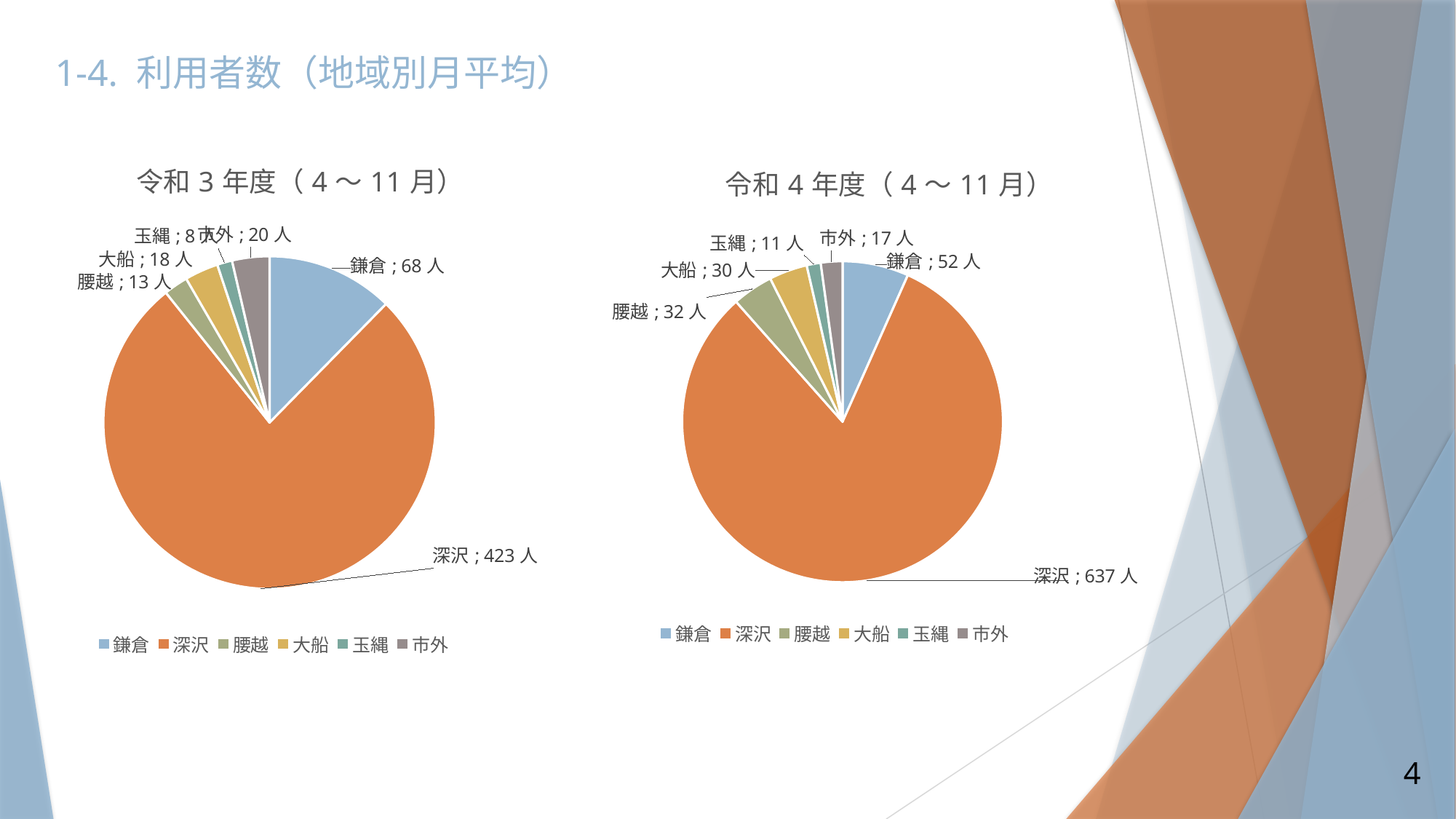
In the 令和4年度（4～11月） chart, what is the value for 鎌倉? 52 人 In the 令和3年度（4～11月） chart, which is larger, 大船 or 市外? 市外 In the 令和4年度（4～11月） chart, which category has the largest value? 深沢 In the 令和3年度（4～11月） chart, what is the difference between 鎌倉 and 大船? 50 人 What type of chart is used for 令和4年度（4～11月）? Pie chart In the 令和4年度（4～11月） chart, what is the value for 腰越? 32 人 In the 令和4年度（4～11月） chart, which is larger, 玉縄 or 市外? 市外 What colour represents 深沢 in the legend of the 令和4年度（4～11月） chart? Orange How many categories does the 令和3年度（4～11月） pie chart have? 6 In the 令和3年度（4～11月） chart, which category has the smallest value? 玉縄 What is the difference between the 深沢 values in the 令和4年度 chart and the 令和3年度 chart? 214 人 In the 令和3年度（4～11月） chart, what is the value for 深沢? 423 人